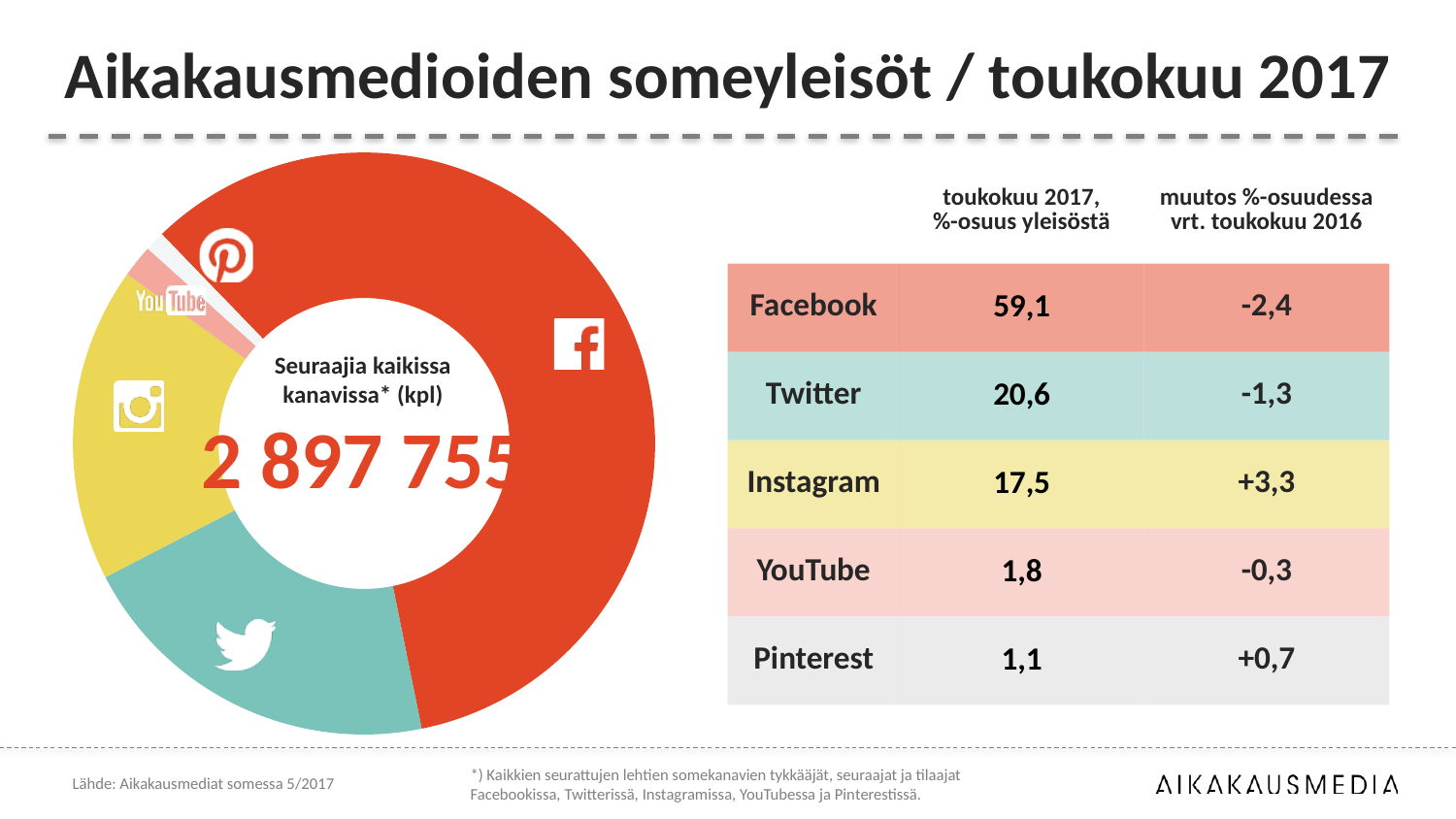
What is the difference in percentage share between Facebook (59,1) and Twitter (20,6)? 38,5 According to the table, what is Instagram's share of the audience in May 2017 (%)? 17,5 What is the title of the slide? Aikakausmedioiden someyleisöt / toukokuu 2017 What is the change in Facebook's percentage share compared with May 2016? -2,4 How many social media channels are shown as slices in the donut chart? 5 What kind of chart is shown on the left of the slide? Pie (donut) chart According to the table, what is Facebook's share of the audience in May 2017 (%)? 59,1 Which channel has the smallest slice in the donut chart? Pinterest Which channel has the largest slice in the donut chart? Facebook Which has a larger share of the audience, Twitter or Instagram? Twitter What total number of followers across all channels is shown in the centre of the donut chart? 2 897 755 What is the change in Instagram's percentage share compared with May 2016? +3,3